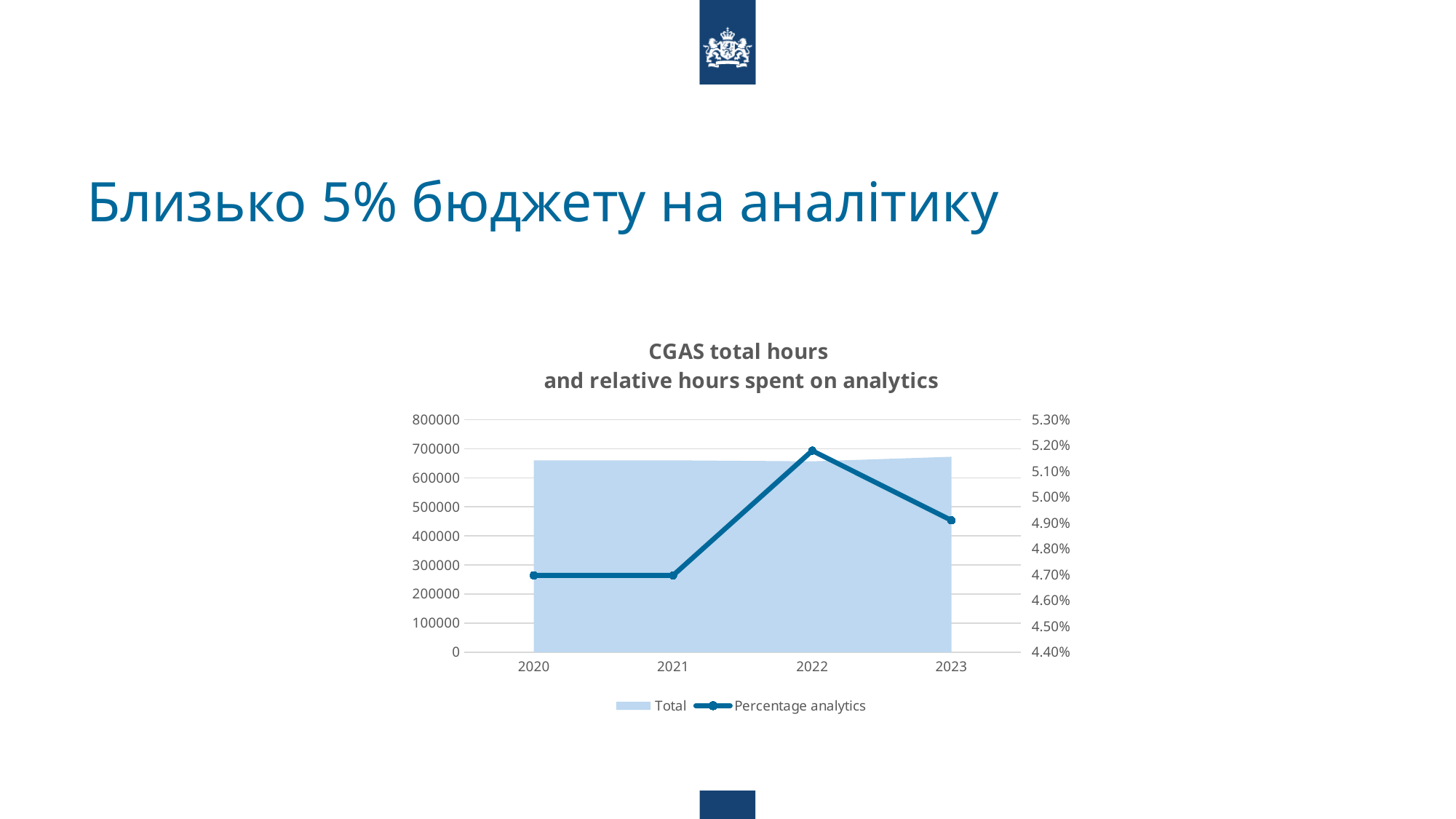
In which year is the Percentage analytics value highest? 2022 Is the Percentage analytics value for 2020 greater or less than 4.80%? less How many series does the chart's legend list? 2 Is the Percentage analytics value for 2022 greater or less than 5.00%? greater Is the Total value for 2021 greater or less than 600000? greater How many years are plotted on the x axis of the chart? 4 What are the two series named in the chart's legend? Total and Percentage analytics Does the Percentage analytics line rise or fall from 2022 to 2023? fall What is the title of the chart? CGAS total hours and relative hours spent on analytics What kind of chart is shown on the slide? A combined area and line chart Which year has the larger Percentage analytics value, 2022 or 2023? 2022